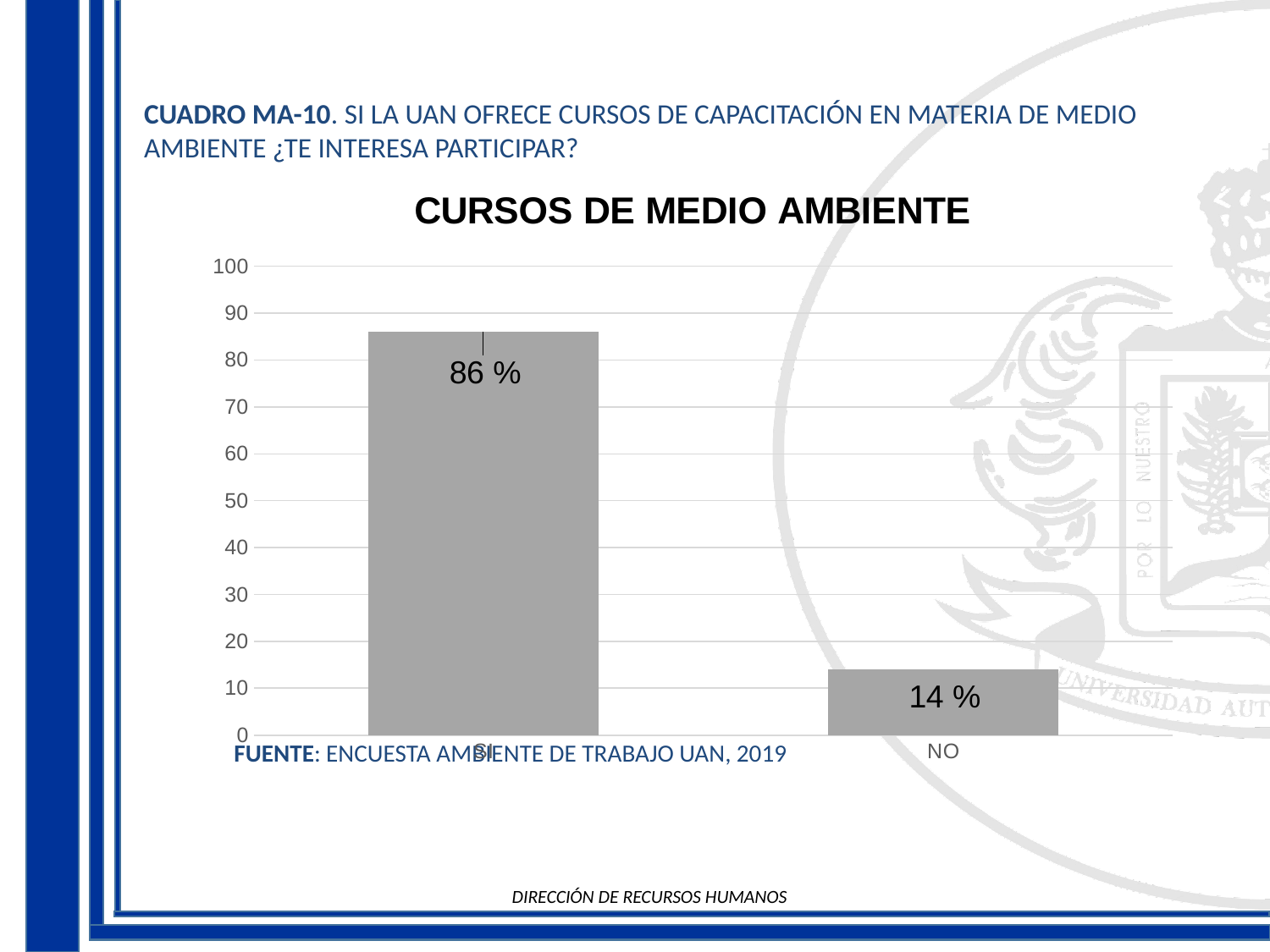
Is the value for SI greater or less than 80? greater What is the maximum value shown on the vertical axis? 100 Which is larger, the value for SI or the value for NO? SI How many bars (categories) does the chart show? 2 Which category has the lowest value? NO What is the value shown for the NO category? 14 % What is the value shown on the first (left) bar, for SI? 86 % Which category has the highest value? SI What is the title of the chart? CURSOS DE MEDIO AMBIENTE What type of chart is shown on the slide? bar chart Is the value for NO greater or less than 20? less What is the difference between the SI value and the NO value? 72 %